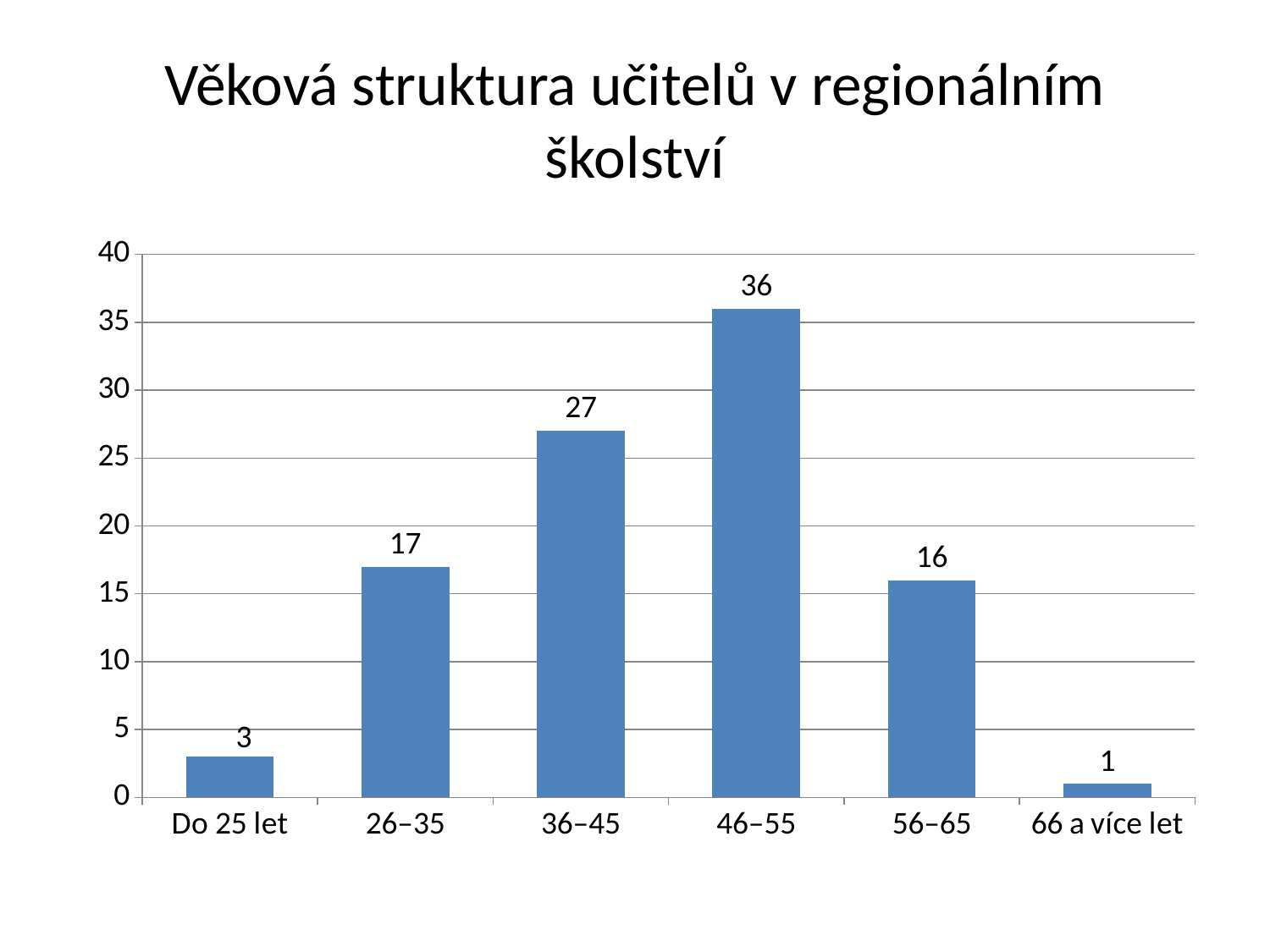
Which age group has the highest value? 46–55 What is the value for the 'Do 25 let' category? 3 What is the difference between the values for 46–55 and 36–45? 9 How many age categories are shown on the x axis? 6 What is the difference between the values for 26–35 and 56–65? 1 Which is larger, the value for 36–45 or the value for 56–65? 36–45 Which age group has the lowest value? 66 a více let What kind of chart is shown on the slide? bar chart What is the title of the slide? Věková struktura učitelů v regionálním školství Is the value for 36–45 greater or less than 25? greater What is the value for the 46–55 age group? 36 What is the value for the 56–65 age group? 16